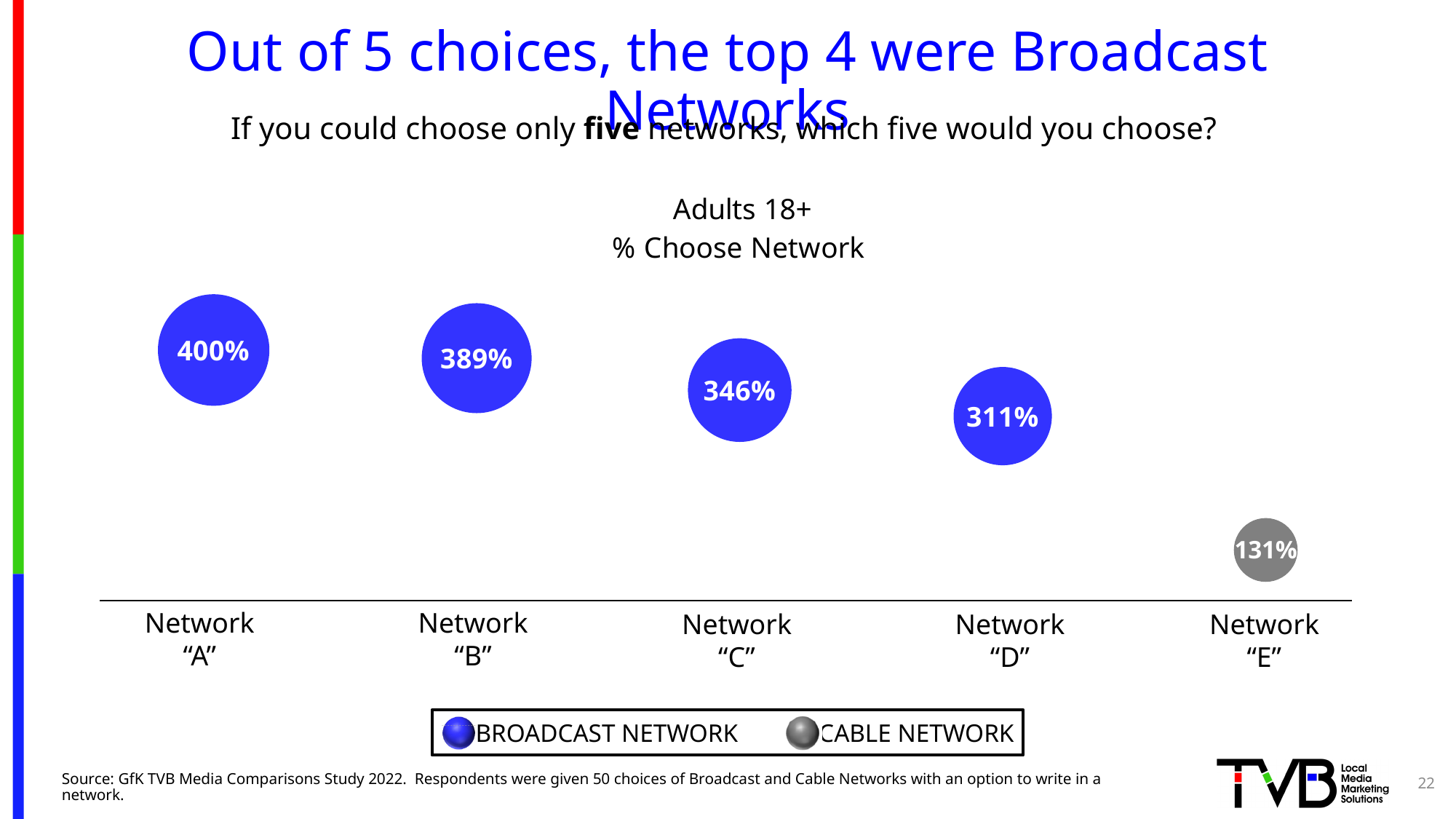
How many networks are shown in the chart? 5 Which network has the lowest value? Network "E" Do the values rise or fall from Network "A" to Network "E"? fall What is the value for Network "E"? 131% How many entries does the legend list? 2 What is the value for Network "C"? 346% Which network is shown as a Cable Network in the chart? Network "E" What is the value for Network "A"? 400% Which has a larger value, Network "B" or Network "D"? Network "B" What is the difference between the values for Network "A" and Network "B"? 11% Which network has the highest value? Network "A" What is the difference between the values for Network "D" and Network "E"? 180%